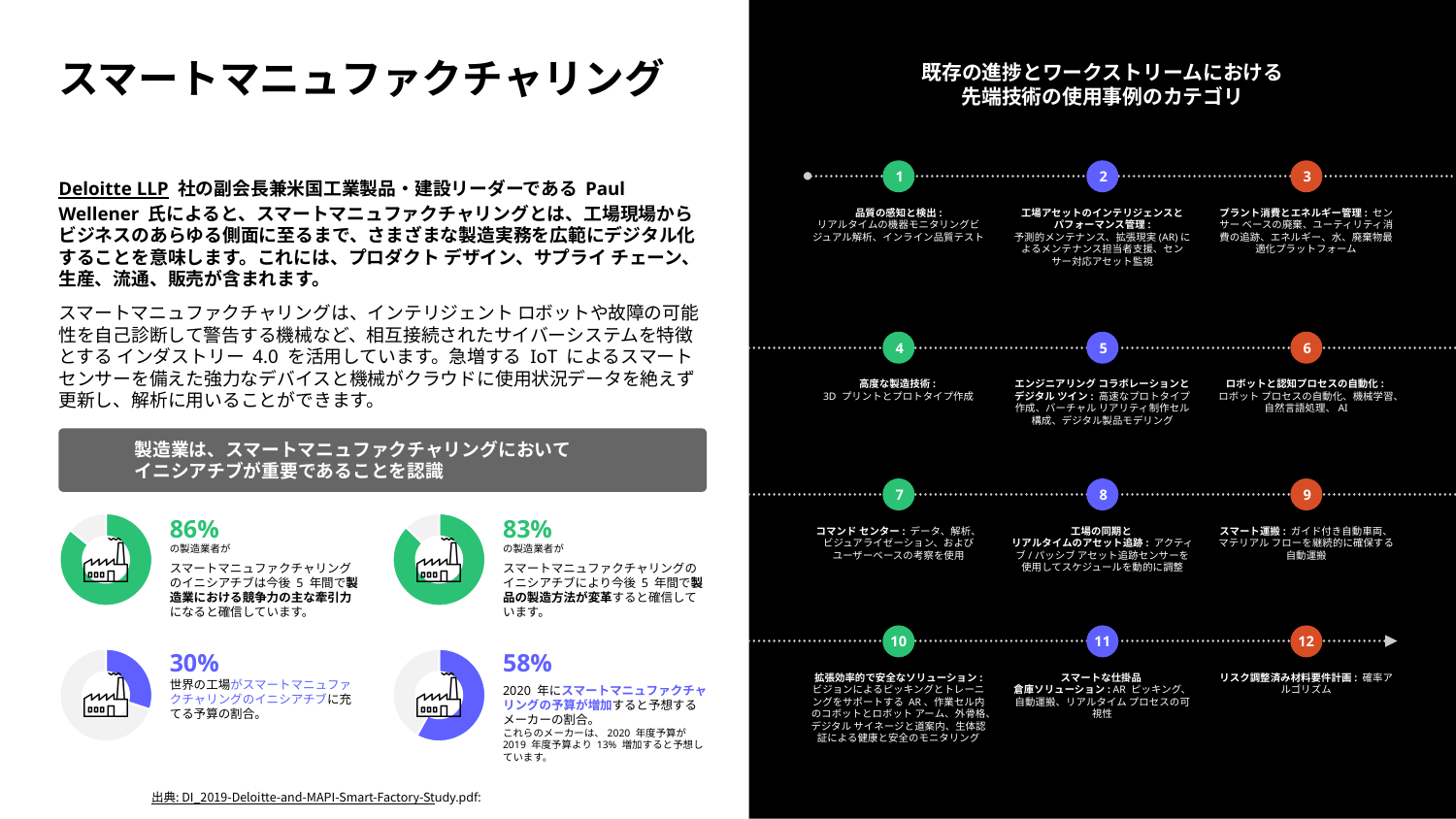
What kind of chart is used to display the four percentages on the left side of the slide? Donut (pie) chart What is the difference between the percentages in the top-left (86%) and top-right (83%) donut charts? 3 percentage points What colour is used for the filled portion of the two top donut charts (86% and 83%)? Green What percentage is shown by the top-right donut chart (manufacturers who believe smart manufacturing initiatives will transform how products are made in the next 5 years)? 83% What percentage is shown by the top-left donut chart (manufacturers who believe smart manufacturing initiatives will be the main driver of competitiveness in the next 5 years)? 86% Which is larger: the percentage in the bottom-right donut chart or the percentage in the bottom-left donut chart? The bottom-right chart (58%) What percentage is shown by the bottom-left donut chart (share of factory budgets worldwide allocated to smart manufacturing initiatives)? 30% How many donut charts are shown on the slide? 4 What is the difference between the percentages in the bottom-right (58%) and bottom-left (30%) donut charts? 28 percentage points What percentage is shown by the bottom-right donut chart (manufacturers expecting to increase their smart manufacturing budget in 2020)? 58% Which of the four donut charts on the left side of the slide shows the highest percentage? The top-left chart (86%) Which of the four donut charts on the left side of the slide shows the lowest percentage? The bottom-left chart (30%)